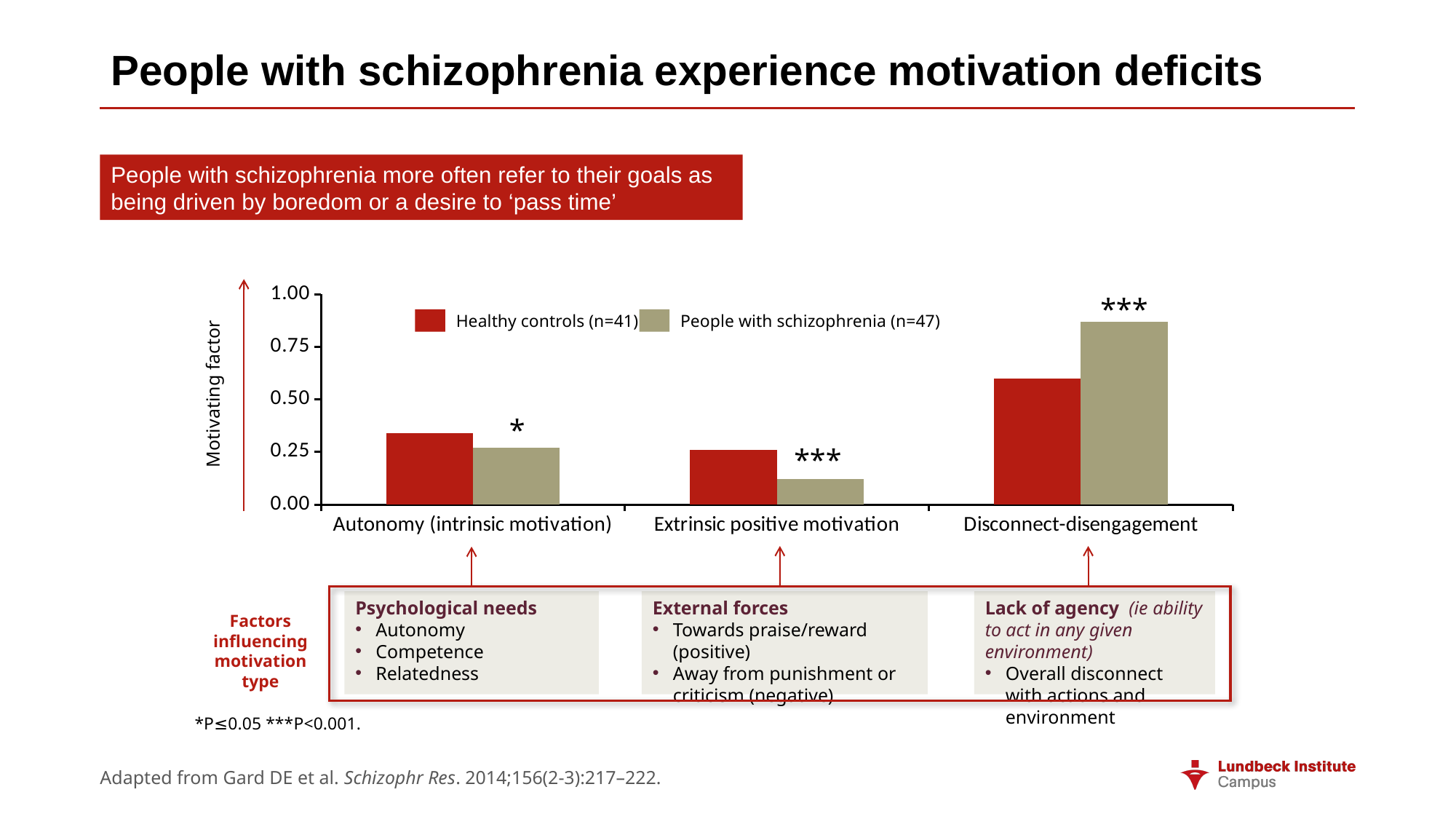
Which two groups are listed in the chart's legend? Healthy controls (n=41) and People with schizophrenia (n=47) What is the label of the chart's y axis? Motivating factor How many series does the chart's legend list? 2 How many categories are shown on the x axis of the chart? 3 For the People with schizophrenia series, which category has the highest value? Disconnect-disengagement In the Disconnect-disengagement category, which group has the larger value? People with schizophrenia (n=47) Is the value for Healthy controls in the Disconnect-disengagement category greater or less than 0.50? greater Is the value for People with schizophrenia in the Extrinsic positive motivation category greater or less than 0.25? less Is the value for Healthy controls in the Autonomy (intrinsic motivation) category greater or less than 0.25? greater In the Extrinsic positive motivation category, which group has the larger value? Healthy controls (n=41) What kind of chart is shown on the slide? bar chart